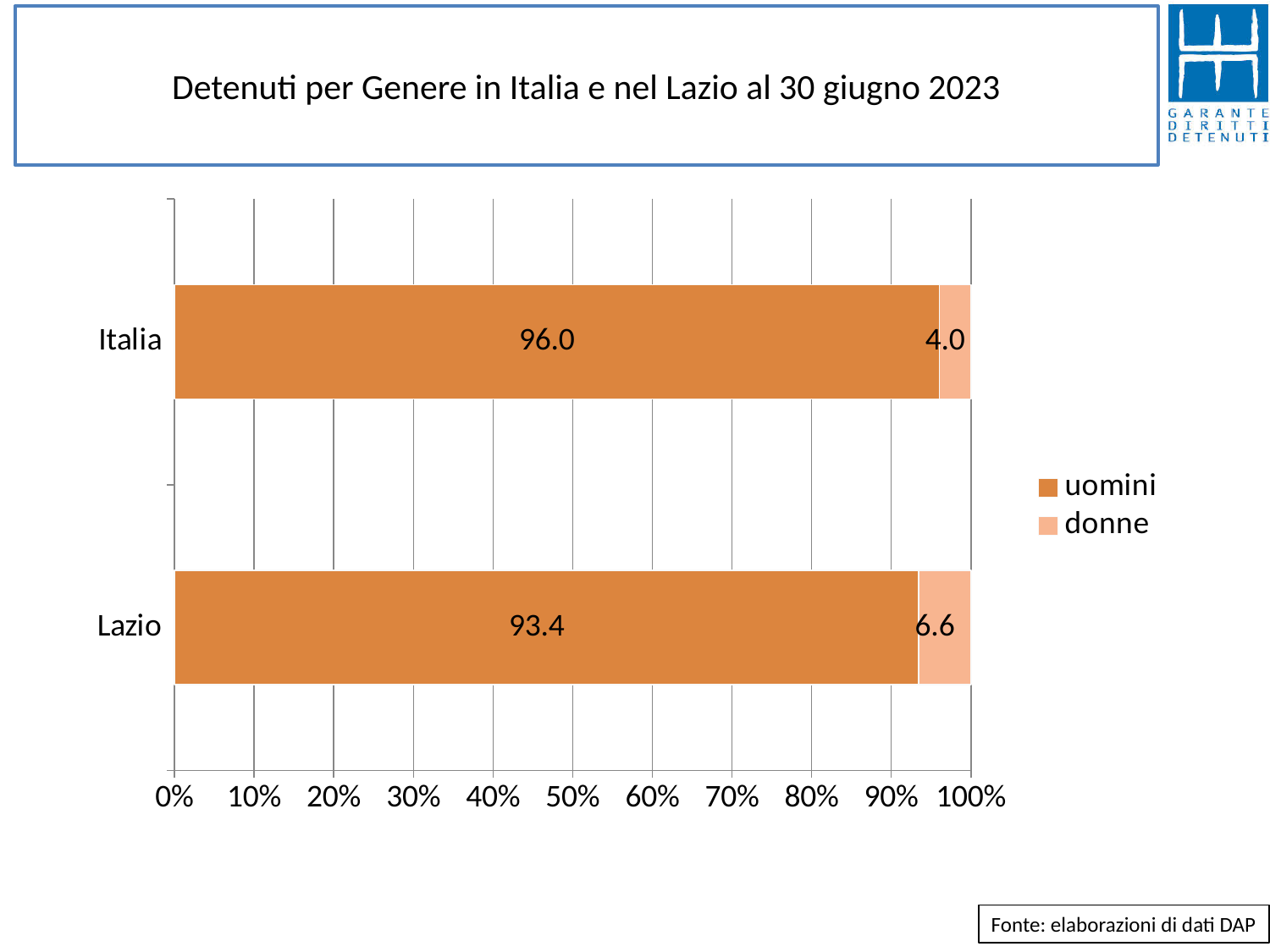
How many series does the legend list? 2 Which category has the higher value for donne, Italia or Lazio? Lazio What is the value for uomini in Italia? 96.0 What is the value for uomini in Lazio? 93.4 What kind of chart is shown on the slide? Stacked bar chart What is the difference between the uomini values for Italia and Lazio? 2.6 What is the value for donne in Italia? 4.0 What is the title of the chart? Detenuti per Genere in Italia e nel Lazio al 30 giugno 2023 What is the difference between the donne values for Lazio and Italia? 2.6 How many categories are shown on the chart? 2 What is the value for donne in Lazio? 6.6 Which category has the lower value for uomini? Lazio